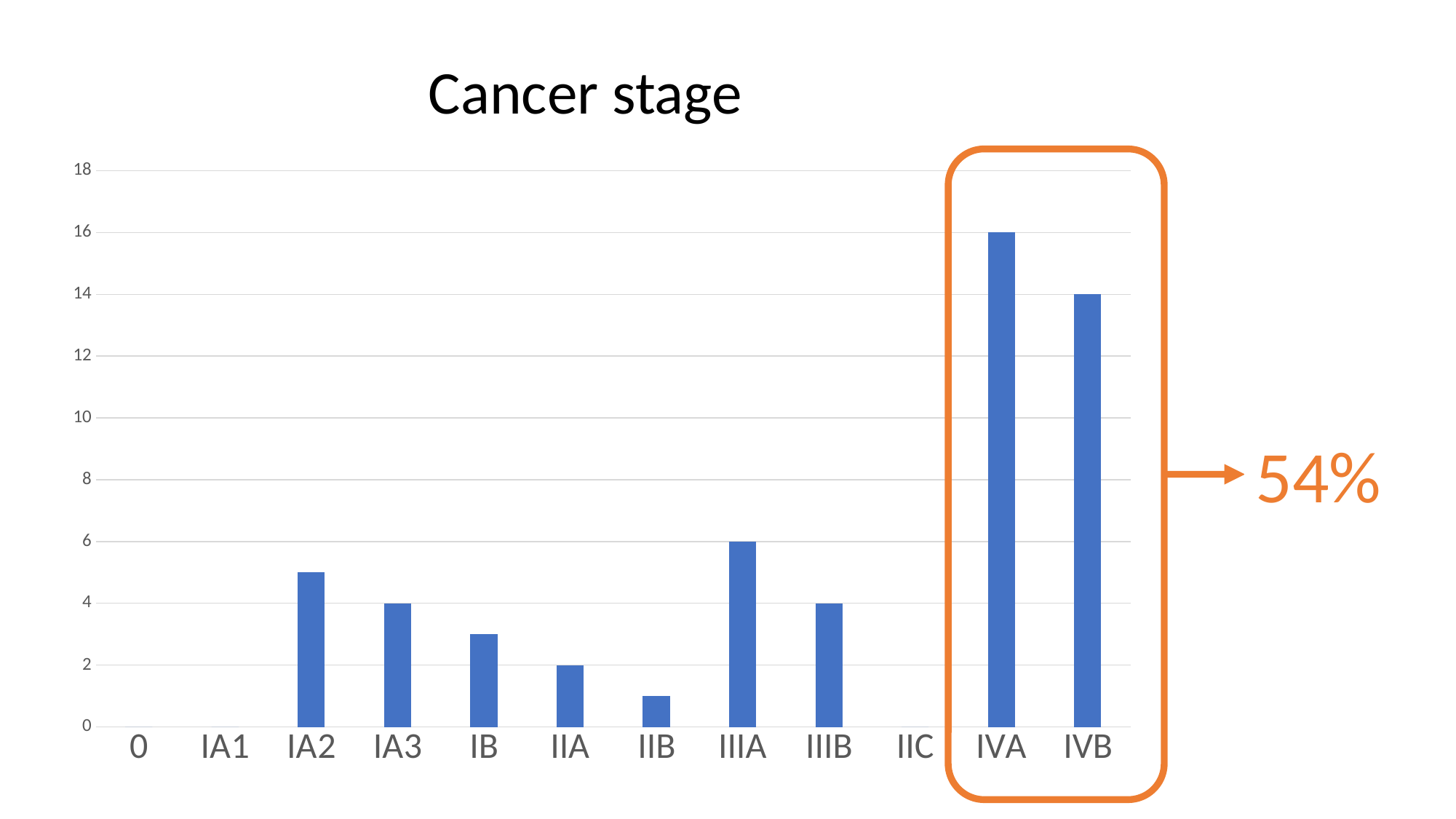
Is the value for stage IA2 greater or less than 4? greater Which is larger, the value for stage IIIA or the value for stage IVB? IVB What is the title of the chart? Cancer stage What kind of chart is shown on the slide? bar chart What is the value for stage IIIA? 6 What is the value for stage IVB? 14 What is the difference between the values for stage IVA and stage IVB? 2 Which cancer stage has the highest value? IVA What percentage is shown in the orange annotation next to the boxed IVA and IVB bars? 54% How many cancer stage categories are shown on the x axis? 12 What is the value for stage IIA? 2 What is the value for stage IVA? 16